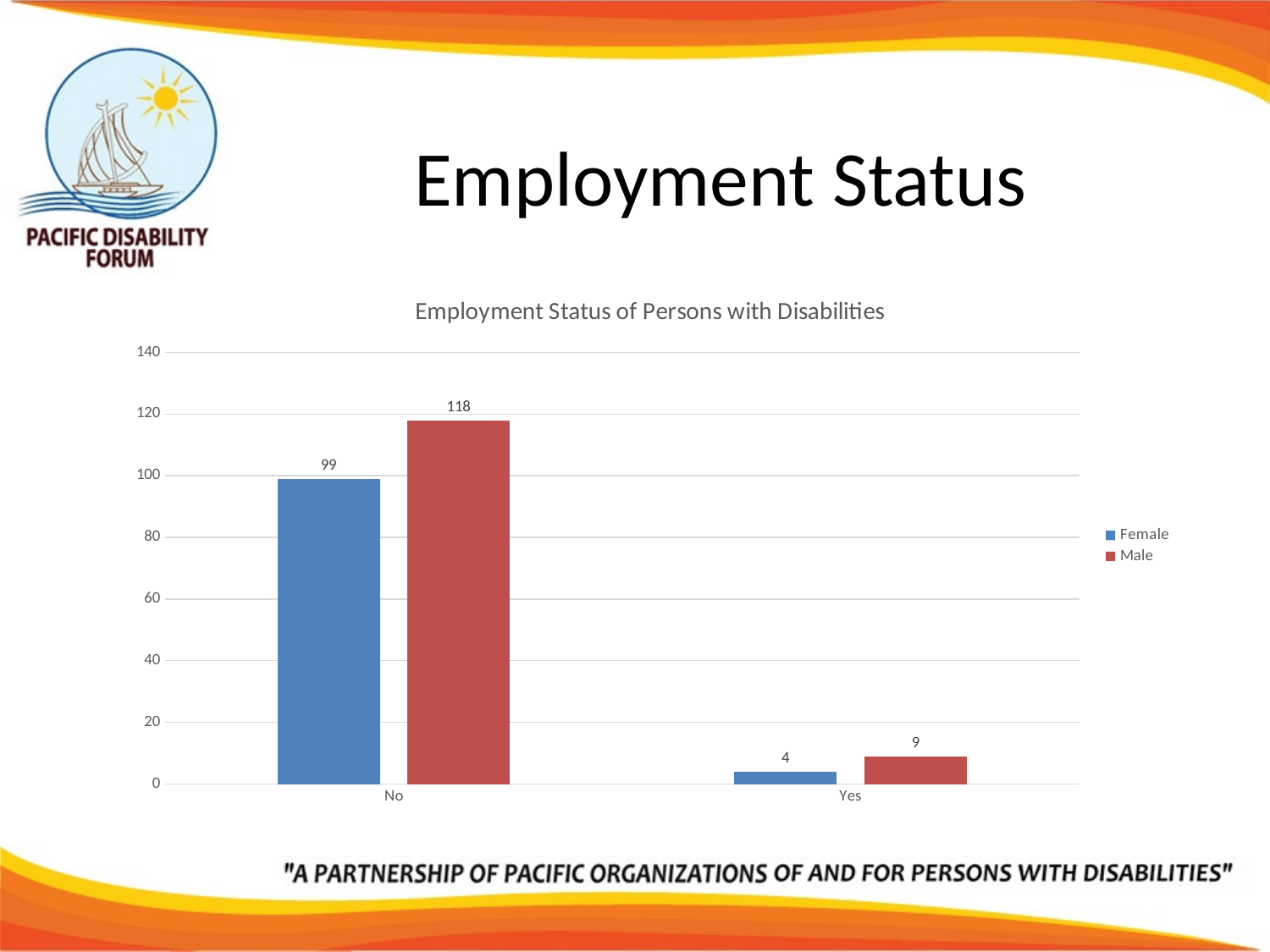
How many series does the legend list? 2 What is the Male value for the "No" category? 118 Which series has the highest value in the "No" category? Male Which bar has the lowest value on the chart? Female, Yes What is the Male value for the "Yes" category? 9 How many categories are shown on the x axis? 2 What is the Female value for the "Yes" category? 4 Is the Male value for "No" greater or less than 100? greater Is the Female value for "No" larger or smaller than the Male value for "No"? smaller What is the difference between the Male and Female values for the "No" category? 19 What is the Female value for the "No" category? 99 What type of chart is shown on the slide? bar chart